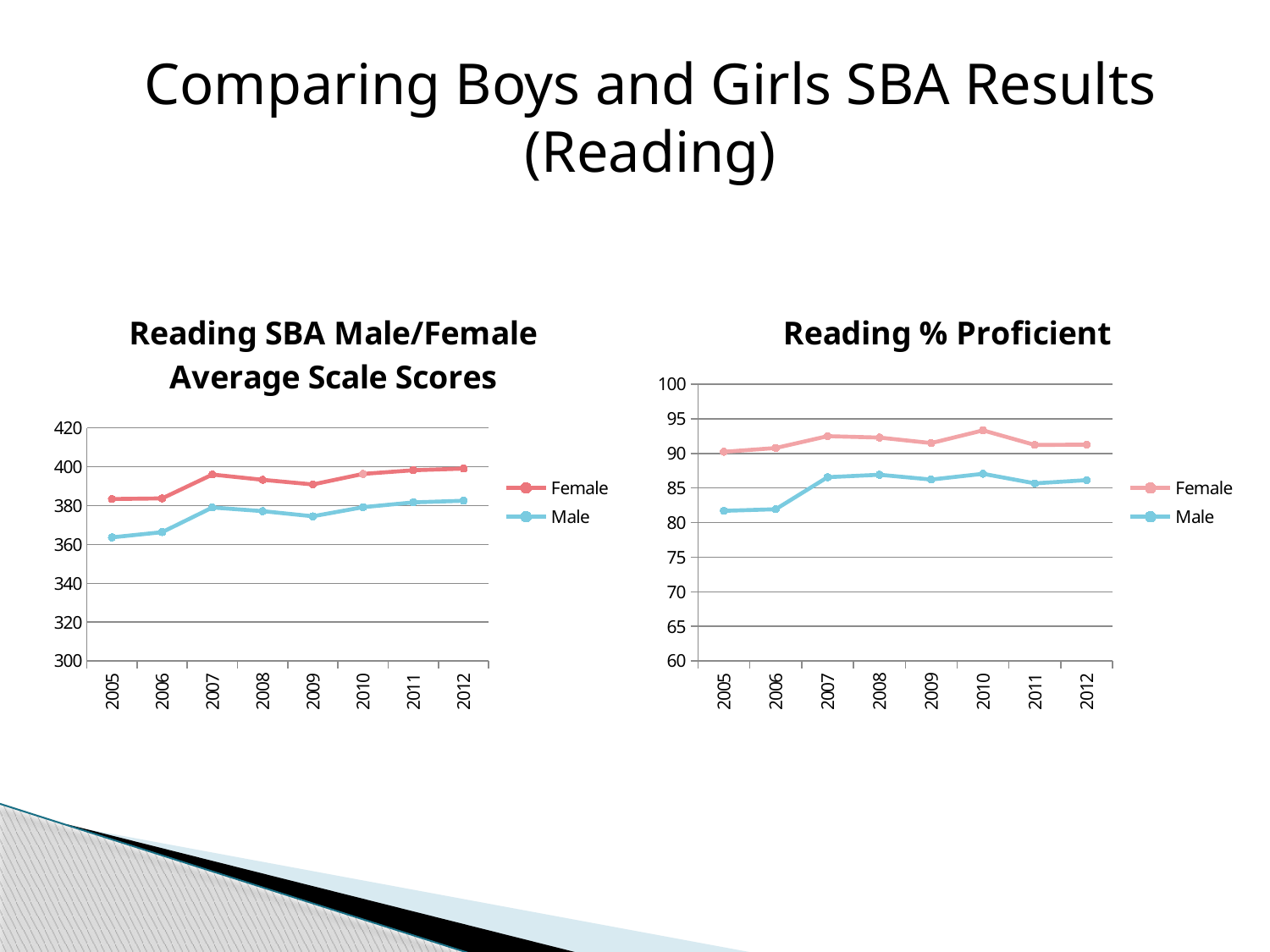
In the 'Reading SBA Male/Female Average Scale Scores' chart, which series has the higher value in 2012, Female or Male? Female In the 'Reading % Proficient' chart, does the Male series rise or fall from 2005 to 2007? rise In the 'Reading SBA Male/Female Average Scale Scores' chart, is the Female value for 2007 greater or less than 380? greater In the 'Reading % Proficient' chart, which series has the higher value in 2007, Female or Male? Female In the 'Reading % Proficient' chart, is the Male value for 2005 greater or less than 85? less In the 'Reading SBA Male/Female Average Scale Scores' chart, is the Male value for 2005 greater or less than 380? less What is the title of the chart on the right side of the slide? Reading % Proficient How many series does the legend of the 'Reading % Proficient' chart list? 2 What are the two legend entries in the 'Reading SBA Male/Female Average Scale Scores' chart? Female and Male How many years are plotted along the x axis of the 'Reading SBA Male/Female Average Scale Scores' chart? 8 What kind of chart is the 'Reading SBA Male/Female Average Scale Scores' chart? line chart